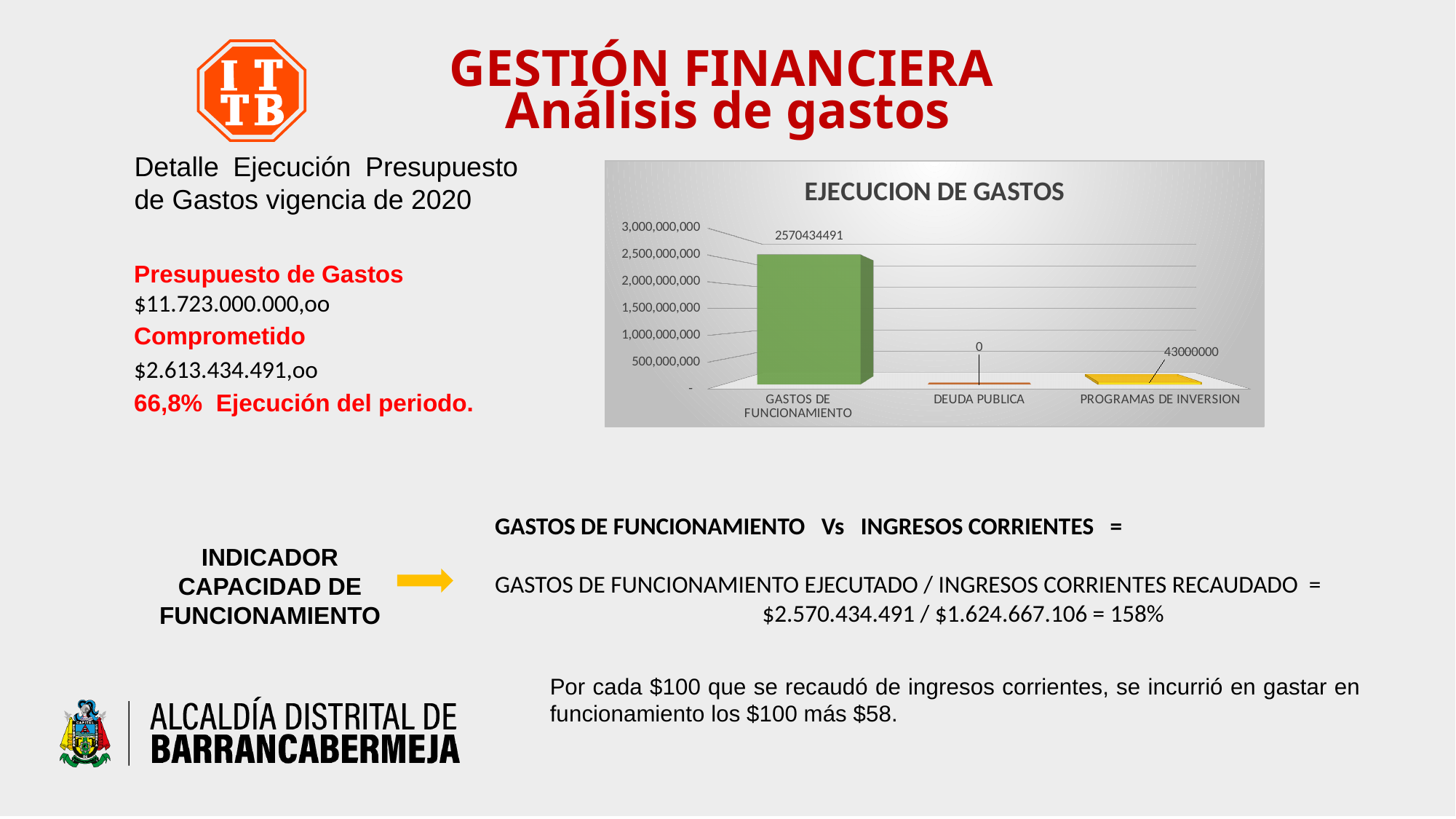
Which is larger, the value for PROGRAMAS DE INVERSION or the value for DEUDA PUBLICA? PROGRAMAS DE INVERSION What is the value for DEUDA PUBLICA in the chart? 0 What is the difference between the values for GASTOS DE FUNCIONAMIENTO and PROGRAMAS DE INVERSION? 2527434491 What type of chart is shown on the slide? bar chart How many categories are shown on the x axis of the chart? 3 What is the title of the chart? EJECUCION DE GASTOS Is the value for GASTOS DE FUNCIONAMIENTO greater or less than 2,000,000,000? greater Is the value for PROGRAMAS DE INVERSION greater or less than 500,000,000? less Which category has the lowest value in the chart? DEUDA PUBLICA What is the value for GASTOS DE FUNCIONAMIENTO in the chart? 2570434491 What is the value for PROGRAMAS DE INVERSION in the chart? 43000000 Which category has the highest value in the chart? GASTOS DE FUNCIONAMIENTO